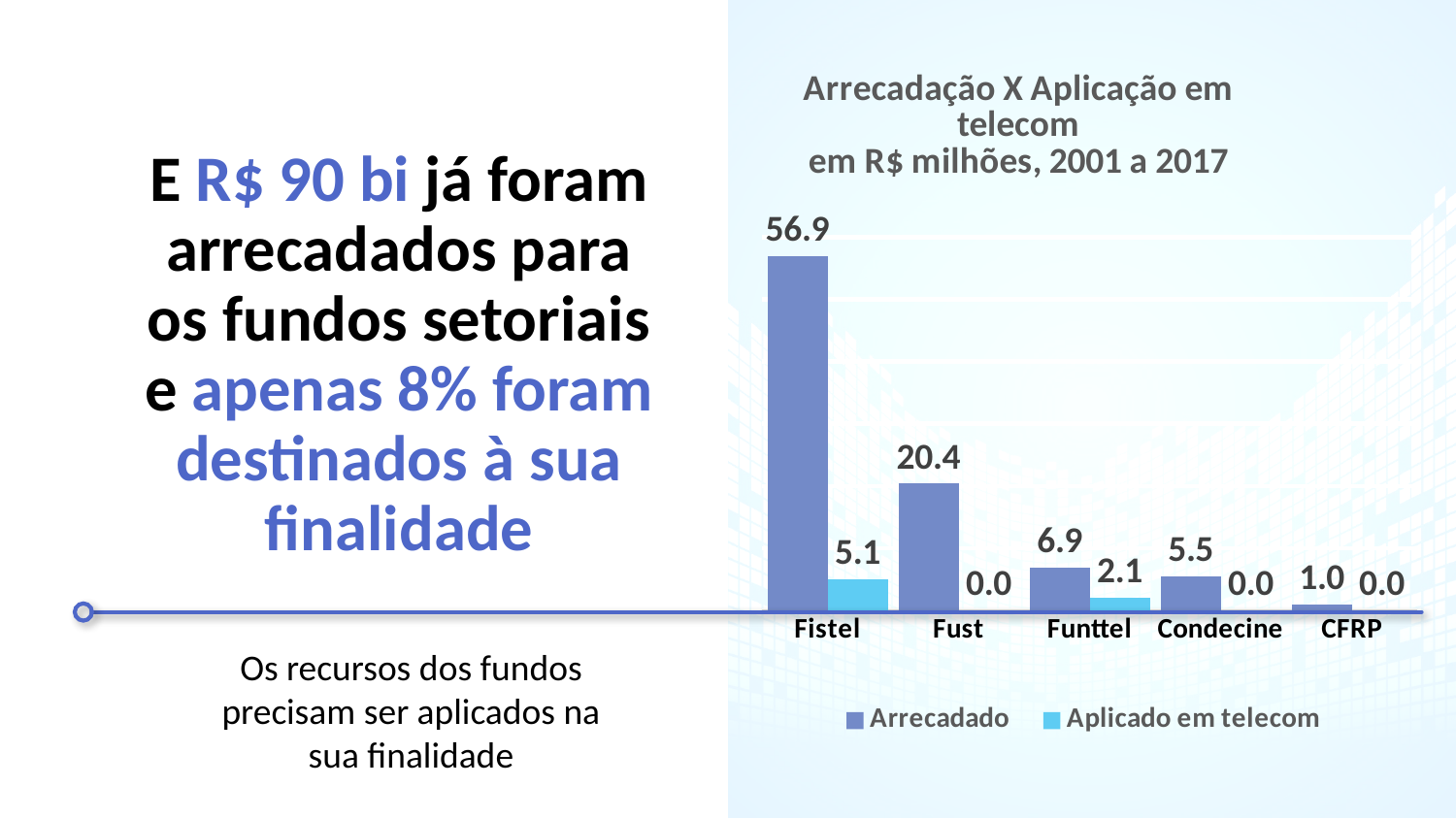
Which category has the highest Arrecadado value? Fistel Which category has the lowest Arrecadado value? CFRP What is the Arrecadado value for Condecine? 5.5 What is the Aplicado em telecom value for Funttel? 2.1 How many series does the legend list? 2 What is the Arrecadado value for Fistel? 56.9 What kind of chart is shown on the slide? Bar chart What is the title of the chart? Arrecadação X Aplicação em telecom em R$ milhões, 2001 a 2017 What is the difference between the Arrecadado and Aplicado em telecom values for Fistel? 51.8 How many categories are shown on the x axis? 5 Do the Arrecadado values rise or fall from Fistel to CFRP along the x axis? Fall Which is larger, the Arrecadado value for Fust or for Funttel? Fust